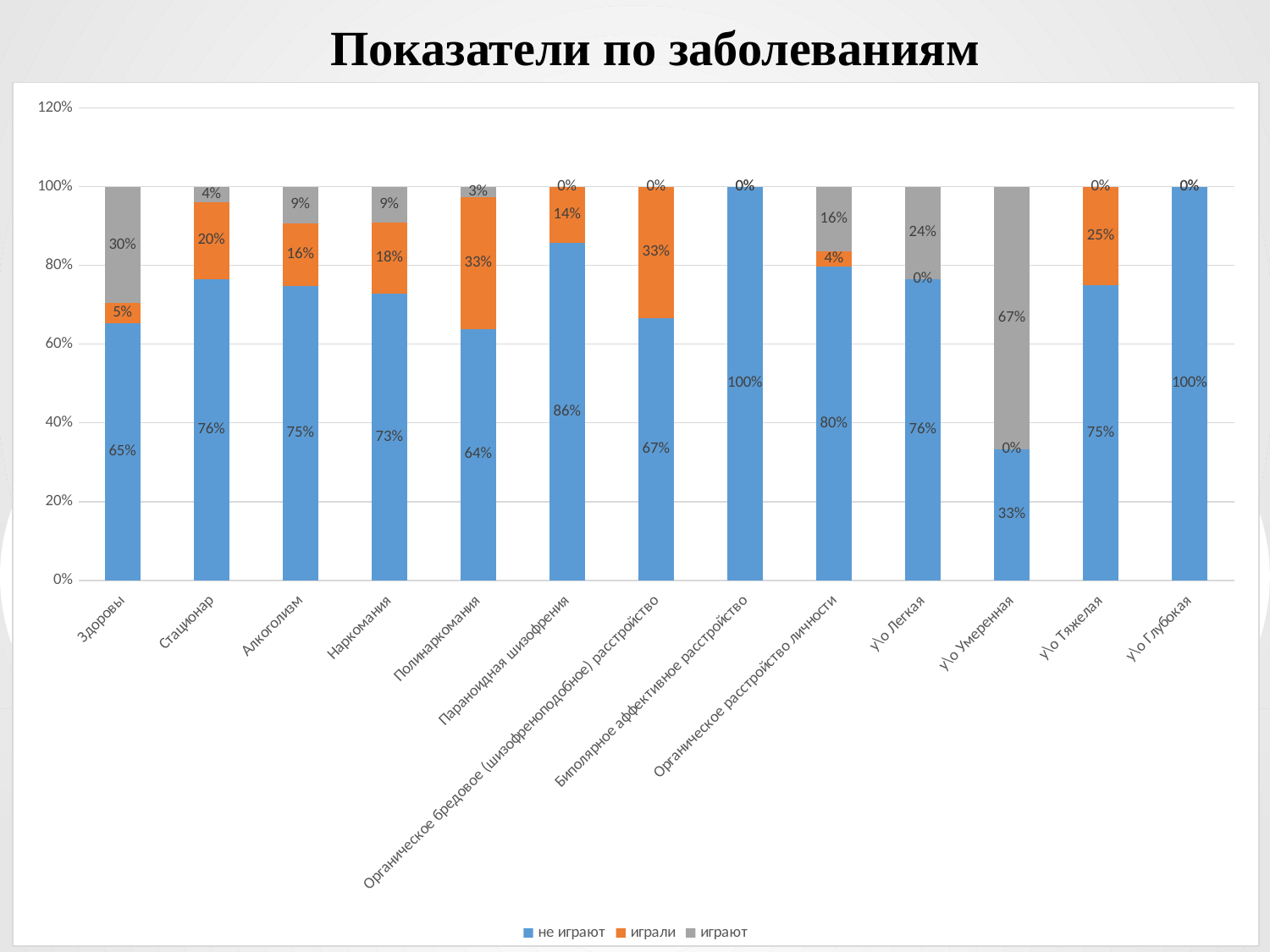
Which category has the highest value for 'играют'? у\о Умеренная What is the title of the chart? Показатели по заболеваниям What is the value of 'играют' for Органическое расстройство личности? 16% What is the value of 'не играют' for Здоровы? 65% What is the value of 'играли' for Полинаркомания? 33% Which is larger: 'играли' for Стационар or 'играли' for Алкоголизм? Стационар What is the difference between 'играют' and 'играли' for Здоровы? 25% What is the value of 'играют' for у\о Умеренная? 67% What type of chart is shown on the slide? stacked bar chart How many series does the legend list? 3 How many categories are shown along the x axis? 13 Which category has the lowest value for 'не играют'? у\о Умеренная